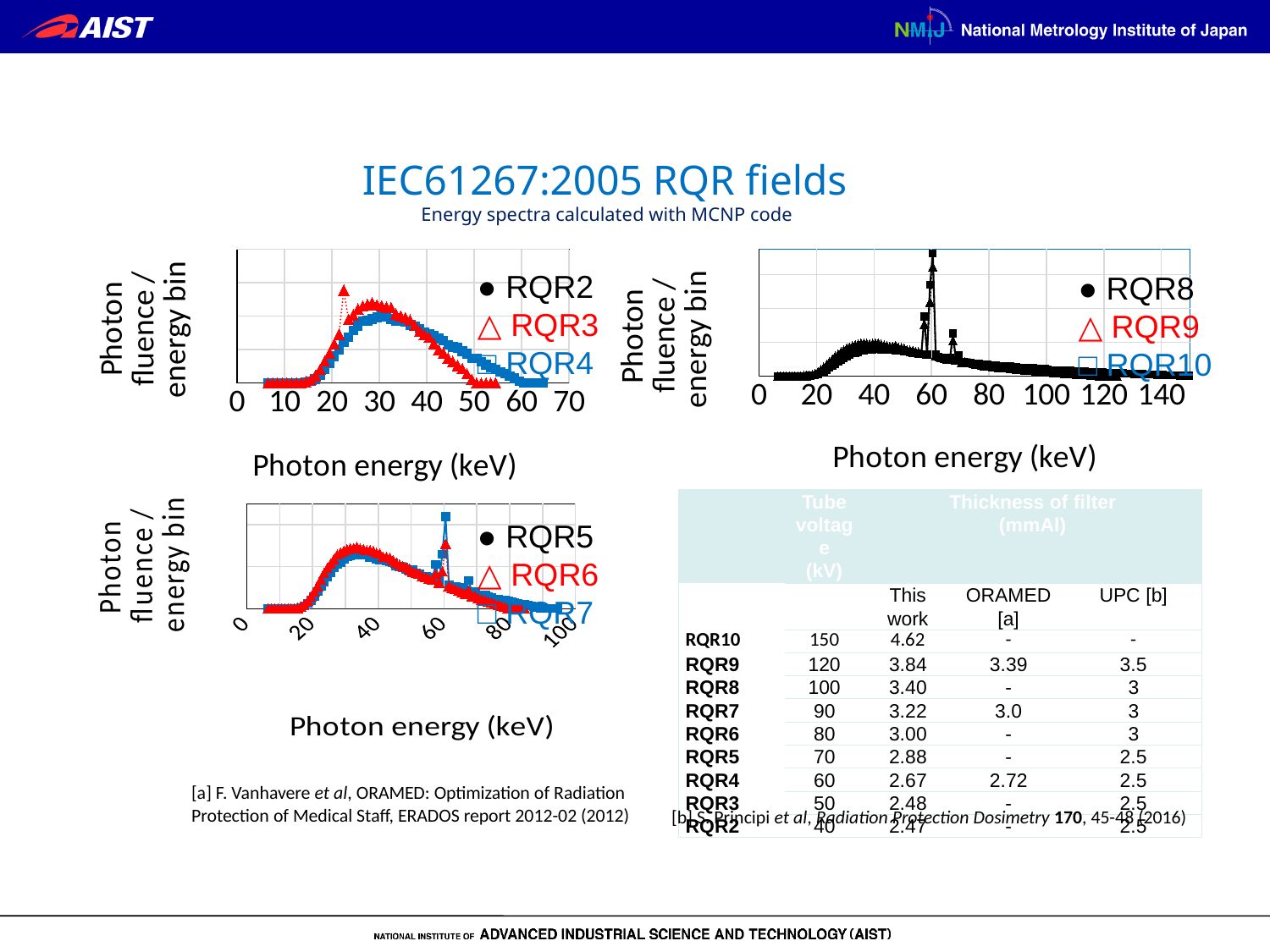
What kind of chart is the top-left chart? scatter chart In the bottom-left chart, is the photon energy of the sharp narrow peak greater or less than 40 keV? greater What is the x-axis title of the top-left chart? Photon energy (keV) In the top-left chart, is the photon energy at which the RQR3 spectrum peaks greater or less than 40 keV? less In the top-left chart, how many series does the legend list? 3 In the top-right chart, how many series does the legend list? 3 In the bottom-left chart, how many series does the legend list? 3 In the top-right chart, which series is marked with filled black circles in the legend? RQR8 In the top-right chart, is the photon energy of the sharp narrow peak greater or less than 40 keV? greater How many charts are shown on the slide? 3